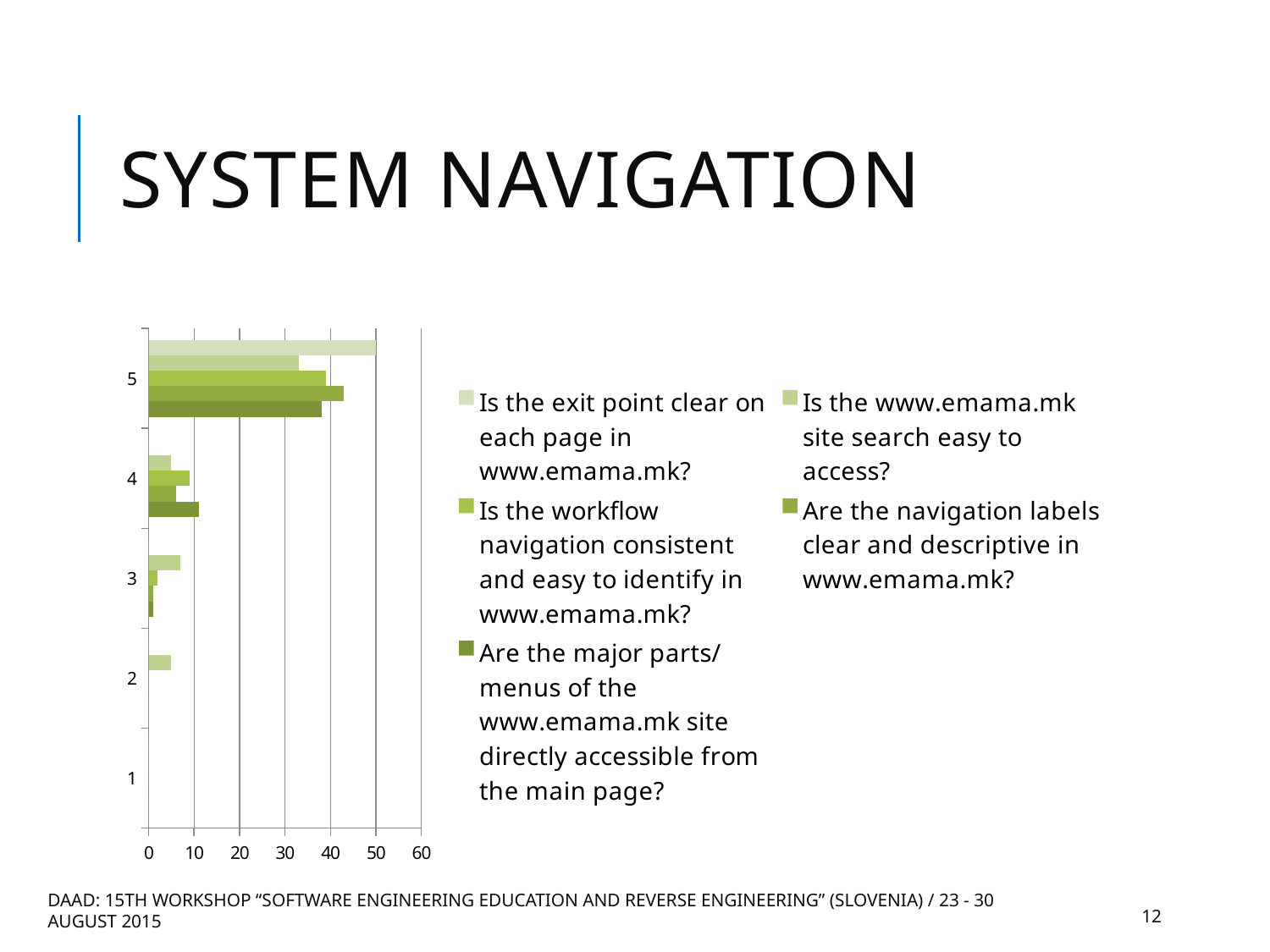
What is the highest tick value shown on the horizontal axis of the chart? 60 Which category shows no visible bars in the chart? 1 What is the title of the slide containing the chart? SYSTEM NAVIGATION For 'Is the exit point clear on each page in www.emama.mk?', which category has the larger value, 5 or 4? 5 Is the value for category 5 for 'Is the exit point clear on each page in www.emama.mk?' greater or less than 40? greater Is the value for category 4 for 'Is the exit point clear on each page in www.emama.mk?' greater or less than 10? less Is the value for category 5 for 'Is the exit point clear on each page in www.emama.mk?' greater or less than 60? less How many series does the chart legend list? 5 How many categories are shown on the vertical axis of the chart? 5 Which category has the longest bars in the chart? 5 What kind of chart is shown on the slide? bar chart